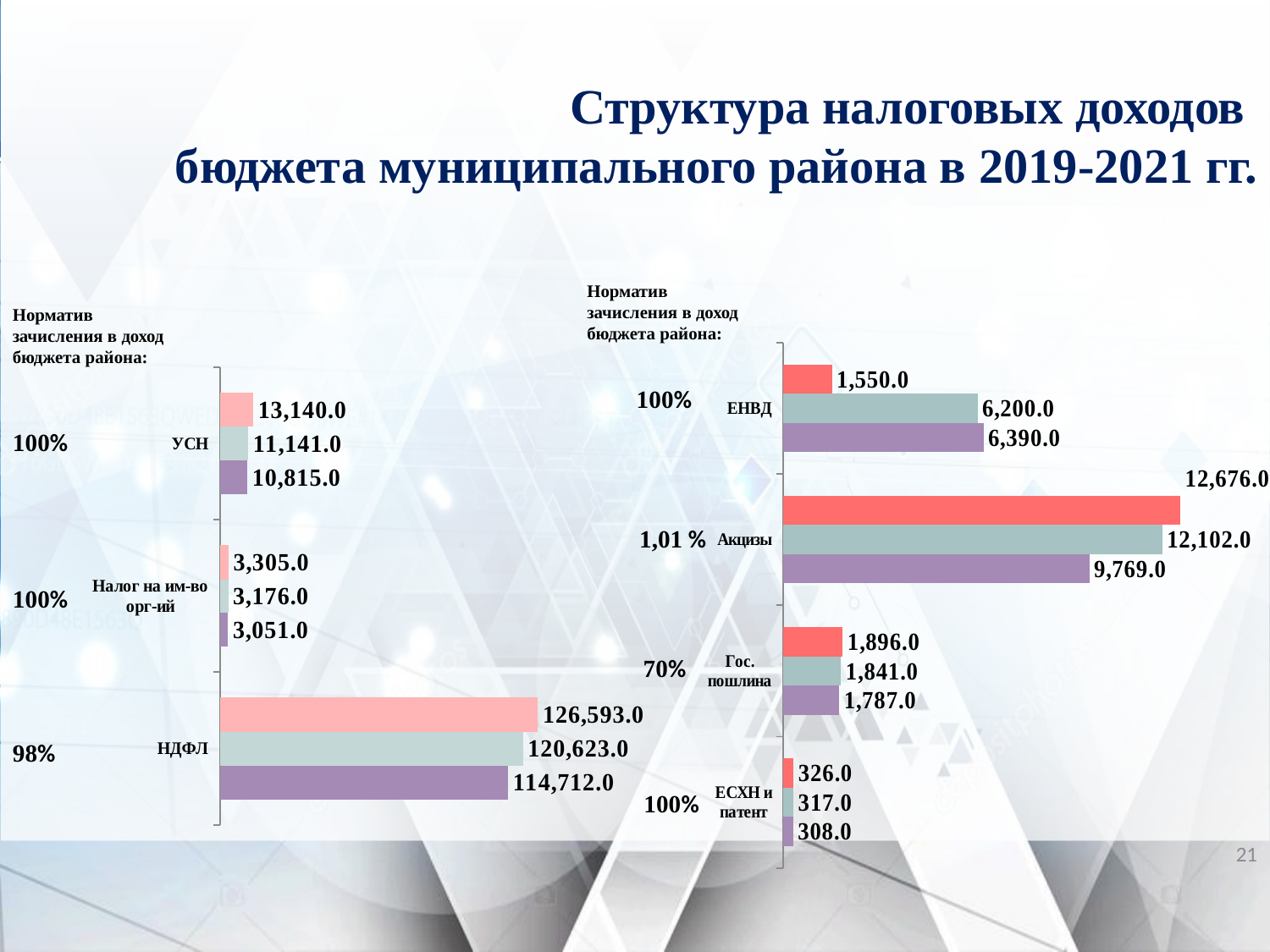
How many categories are shown in the right chart? 4 In the right chart, what is the difference between the purple and pink bars for ЕНВД? 4,840.0 What type of chart is the left chart? bar chart In the right chart, which is larger for ЕНВД: the pink bar or the purple bar? the purple bar In the right chart, what is the value of the pink bar for Гос. пошлина? 1,896.0 In the right chart, which category has the lowest values? ЕСХН и патент In the right chart, what is the value of the grey bar for ЕНВД? 6,200.0 In the left chart, what is the difference between the pink and purple bars for НДФЛ? 11,881.0 In the left chart, which category has the highest value? НДФЛ In the left chart, what is the value of the pink bar for УСН? 13,140.0 In the right chart, what percentage norm is shown next to Акцизы? 1,01 % In the left chart, what is the value of the purple bar for НДФЛ? 114,712.0